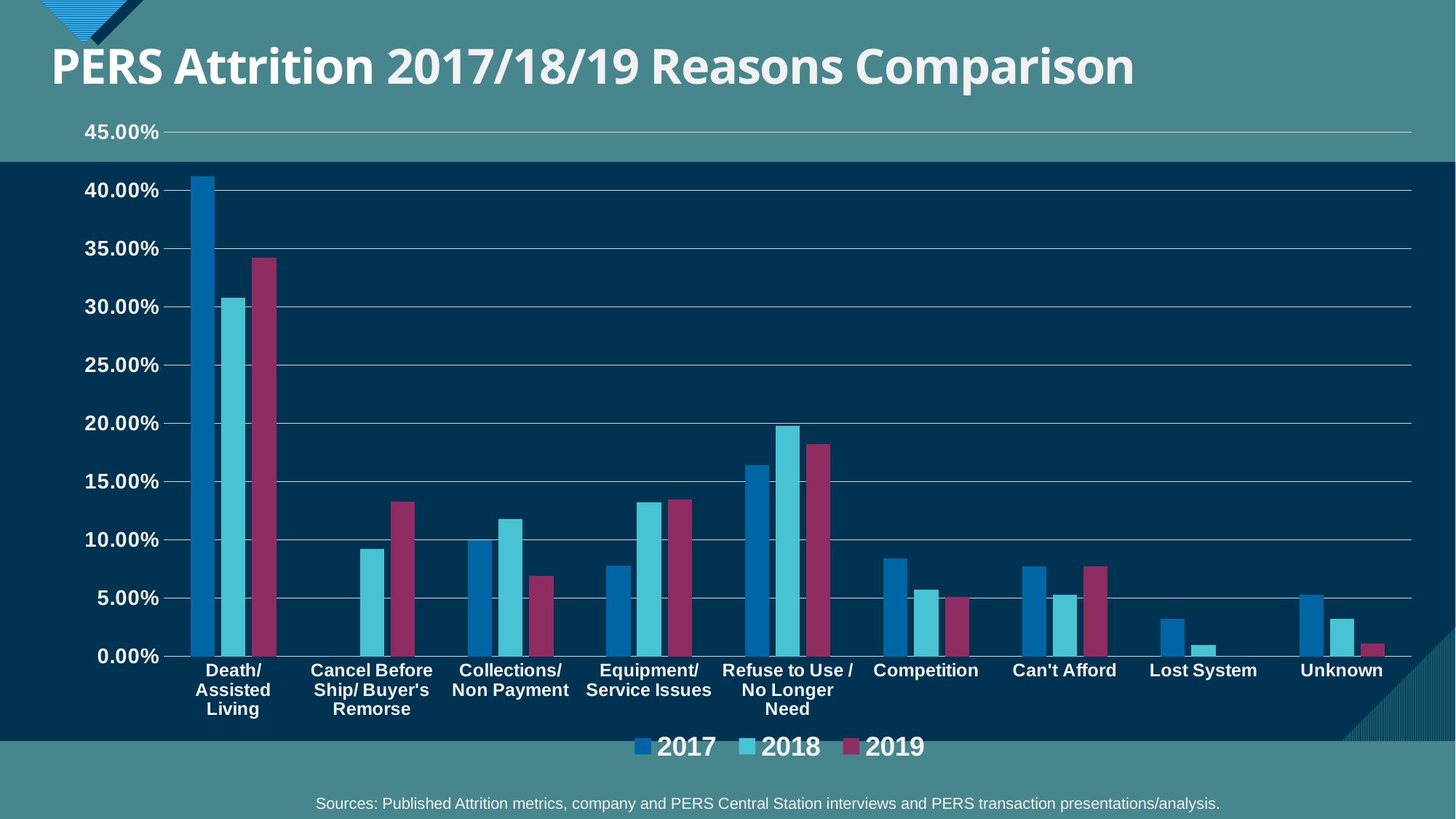
Is the 2017 value for Death/ Assisted Living greater or less than 40.00%? greater Which category has the highest 2018 value? Death/ Assisted Living Is the 2017 value for Refuse to Use / No Longer Need greater or less than 15.00%? greater For the Unknown category, do the values rise or fall from 2017 to 2019? fall For Collections/ Non Payment, which is larger: the 2018 value or the 2019 value? 2018 What kind of chart is shown on the slide? bar chart For Death/ Assisted Living, which is larger: the 2018 value or the 2019 value? 2019 How many reason categories are shown on the x axis? 9 Which category has the lowest 2018 value? Lost System How many series does the legend list? 3 Is the 2017 value for Competition greater or less than 10.00%? less Which category has the highest 2017 value? Death/ Assisted Living